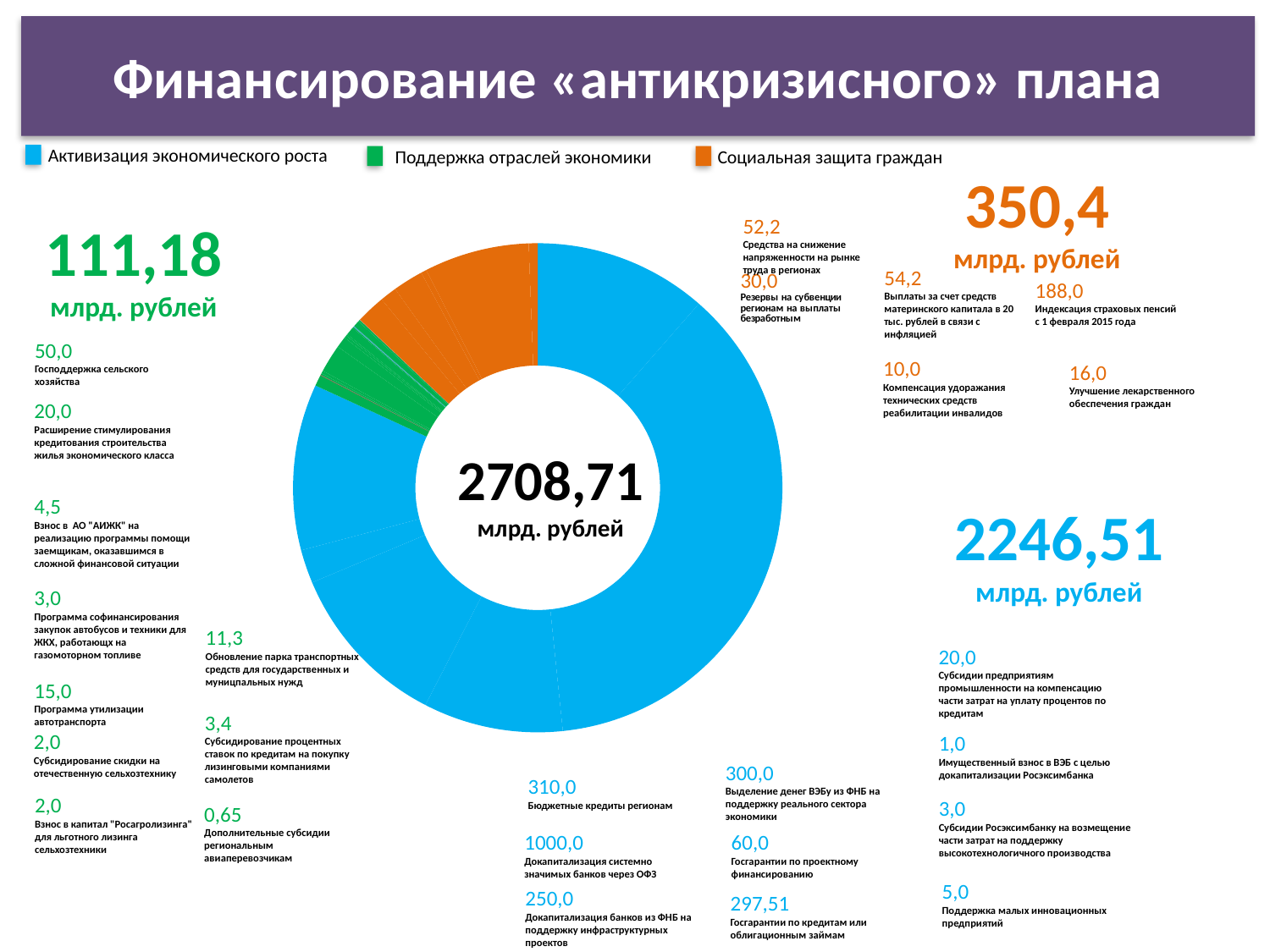
What kind of chart is shown on the slide? Doughnut chart Which is larger: Социальная защита граждан or Поддержка отраслей экономики? Социальная защита граждан What total value is shown in the centre of the donut chart? 2708,71 млрд. рублей What is the value for Поддержка отраслей экономики? 111,18 млрд. рублей How many categories does the legend list? 3 What is the difference between Социальная защита граждан and Поддержка отраслей экономики? 239,22 млрд. рублей Which of the three legend categories has the largest value? Активизация экономического роста Which of the three legend categories has the smallest value? Поддержка отраслей экономики What colour represents Социальная защита граждан in the chart? Orange What is the value for Активизация экономического роста? 2246,51 млрд. рублей What is the value for Социальная защита граждан? 350,4 млрд. рублей What is the value for Индексация страховых пенсий с 1 февраля 2015 года? 188,0